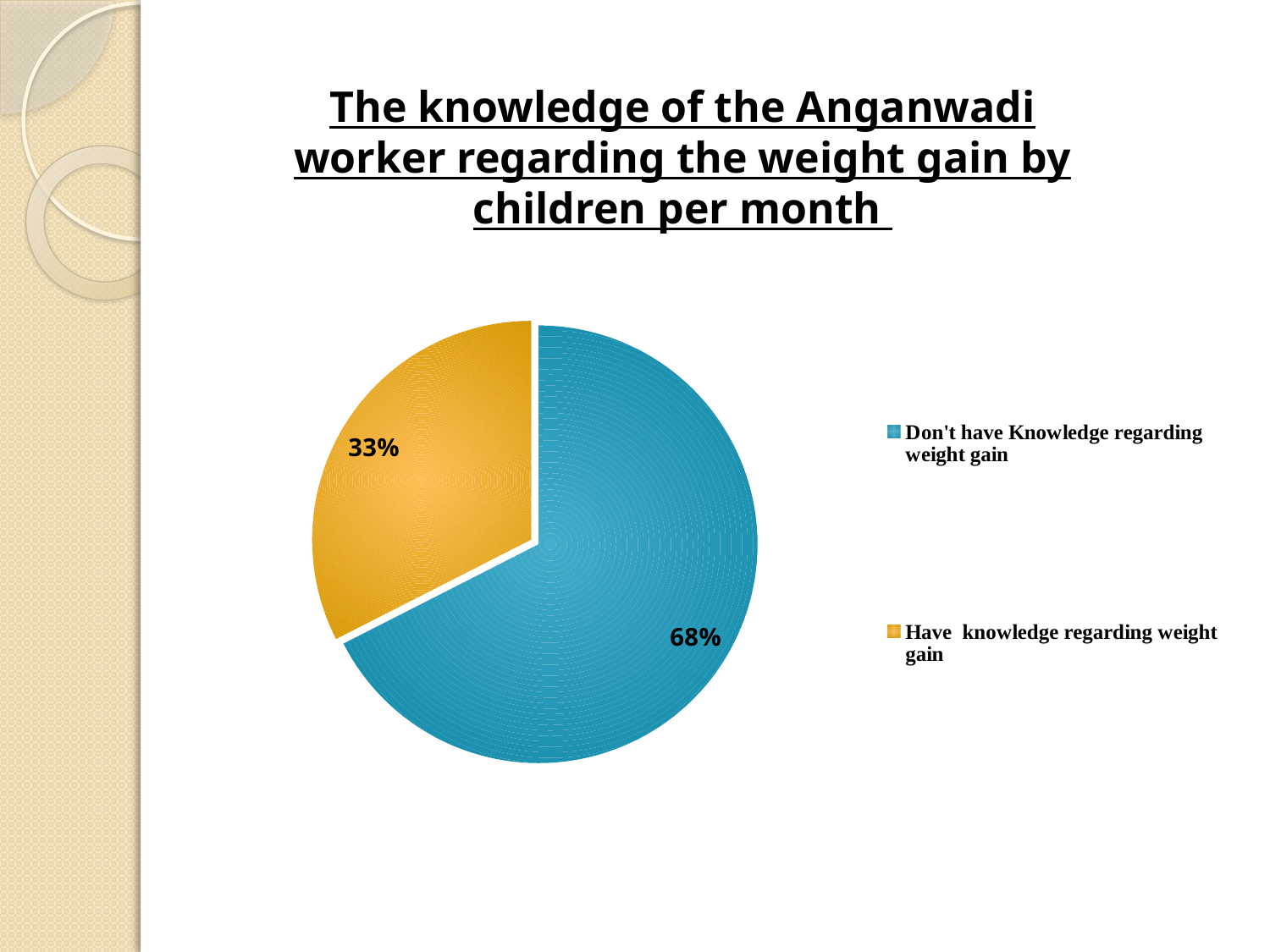
What is the title of the chart on the slide? The knowledge of the Anganwadi worker regarding the weight gain by children per month How many slices does the pie chart have? 2 Which slice of the pie is the largest? Don't have Knowledge regarding weight gain What share of the pie is labelled "Don't have Knowledge regarding weight gain"? 68% What is the difference in percentage points between the "Don't have Knowledge regarding weight gain" slice and the "Have knowledge regarding weight gain" slice? 35 How many entries does the legend list? 2 What colour is the slice for "Have knowledge regarding weight gain"? Orange Which slice of the pie is the smallest? Have knowledge regarding weight gain Which is larger: the share of workers who don't have knowledge regarding weight gain or the share who have knowledge regarding weight gain? Don't have Knowledge regarding weight gain What kind of chart is shown on the slide? Pie chart What share of the pie is labelled "Have knowledge regarding weight gain"? 33%